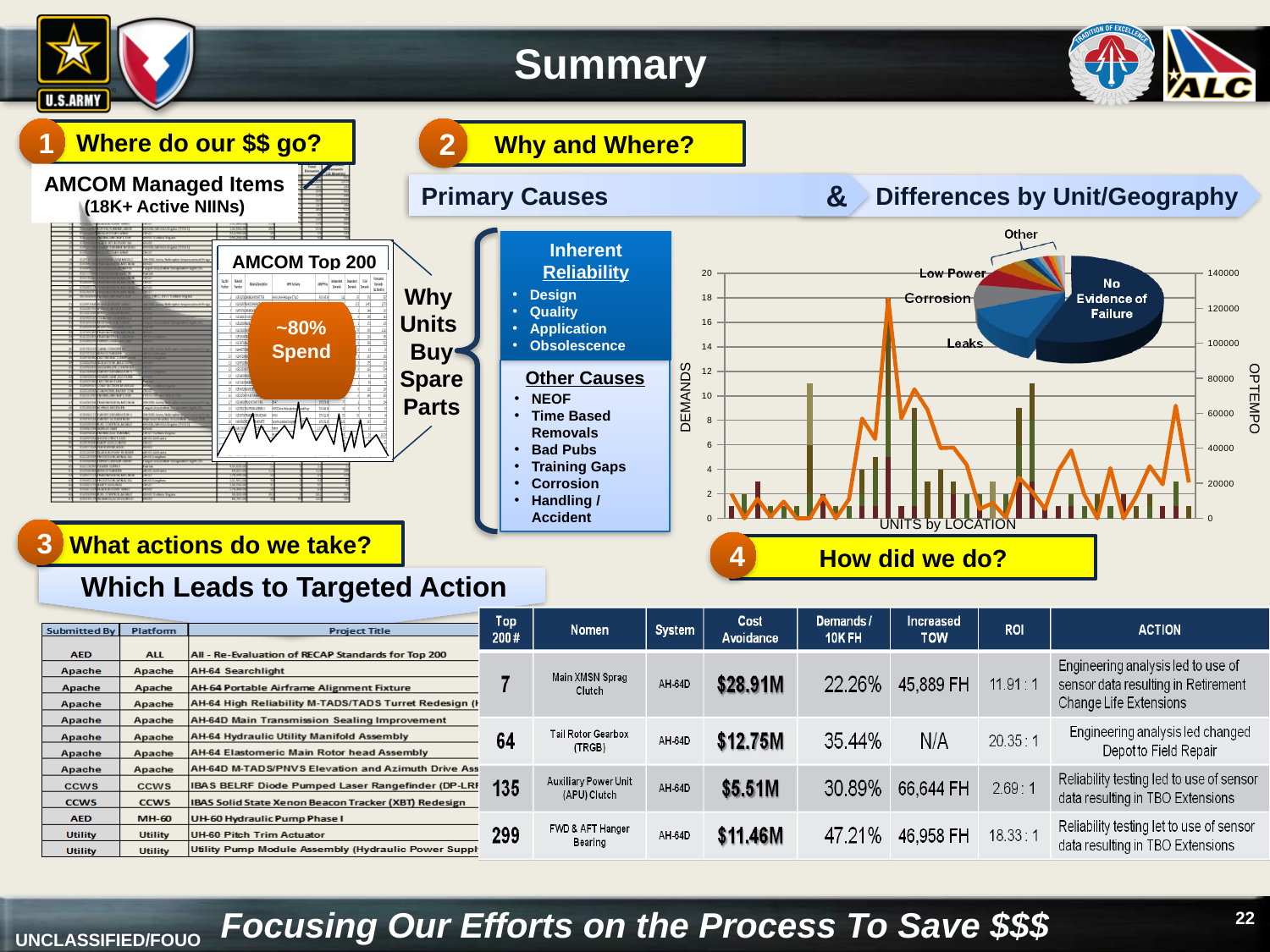
What is the title of the left vertical axis on the bar-and-line chart? DEMANDS In the pie chart, which slice is larger, Leaks or Corrosion? Leaks What is the maximum value shown on the right axis of the bar-and-line chart? 140000 In the pie chart, which slice is larger, No Evidence of Failure or Leaks? No Evidence of Failure On the bar-and-line chart, is the highest point of the OPTEMPO line greater or less than 100000? greater How many slices of the pie chart have text labels? 5 In the pie chart, which labeled slice is the largest? No Evidence of Failure On the bar-and-line chart, is the tallest DEMANDS bar greater or less than 14? greater What is the title of the right vertical axis on the bar-and-line chart? OPTEMPO What is the maximum value shown on the left axis of the bar-and-line chart? 20 What kind of chart is the chart with the slice labeled 'No Evidence of Failure'? Pie chart On the bar-and-line chart, is the tallest DEMANDS bar greater or less than 10? greater